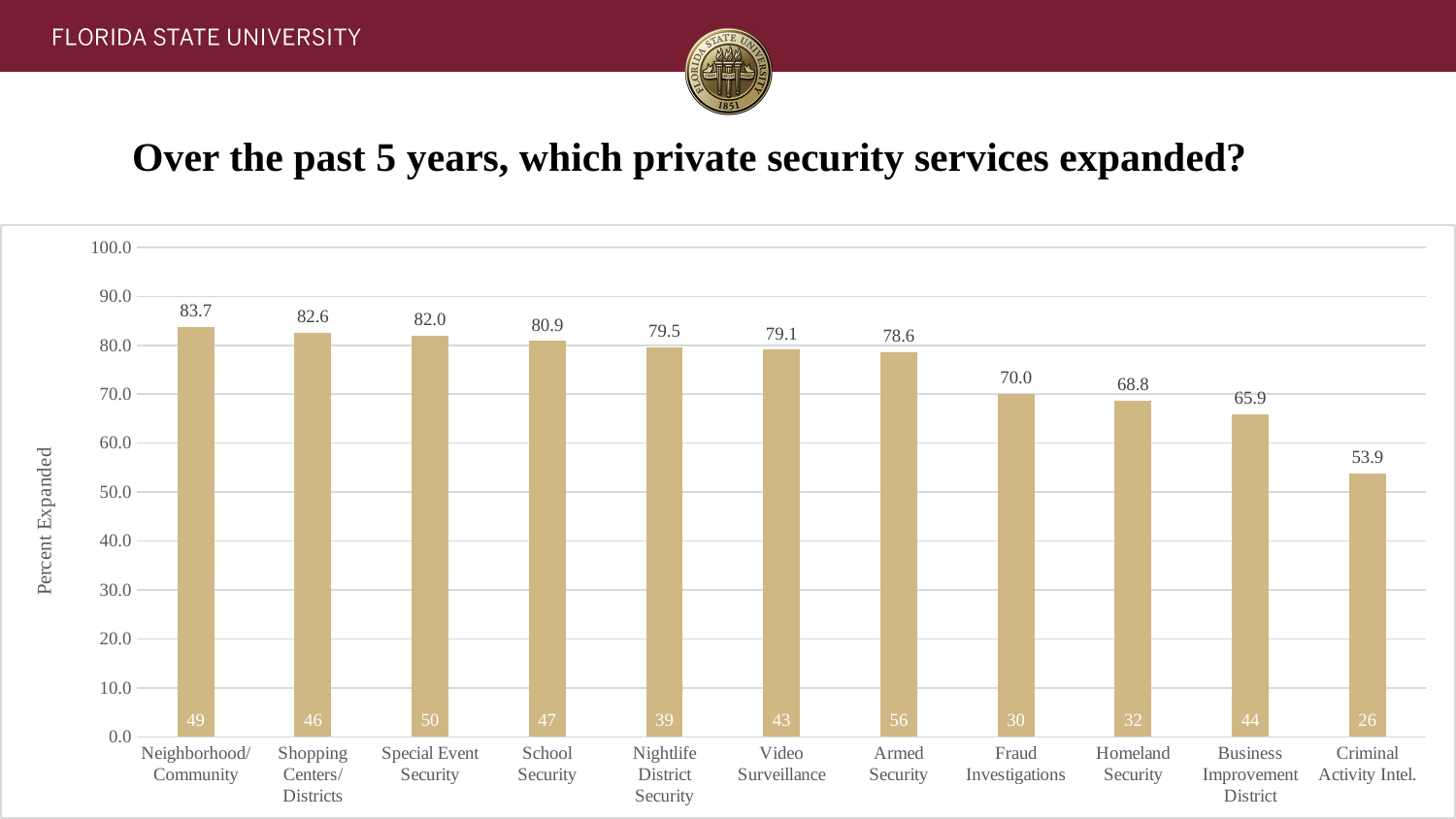
What kind of chart is shown on the slide? Bar chart Is the value for Homeland Security greater or less than 70.0? less Which private security service has the lowest percent expanded? Criminal Activity Intel. What is the percent expanded value for School Security? 80.9 What number is printed inside the bar for Armed Security? 56 What is the difference in percent expanded between Fraud Investigations and Homeland Security? 1.2 Which private security service has the highest percent expanded? Neighborhood/Community What is the difference in percent expanded between Neighborhood/Community and Criminal Activity Intel.? 29.8 How many private security service categories are shown on the chart? 11 What is the label on the vertical axis of the chart? Percent Expanded Which has a higher percent expanded, Video Surveillance or Business Improvement District? Video Surveillance What is the percent expanded value for Fraud Investigations? 70.0